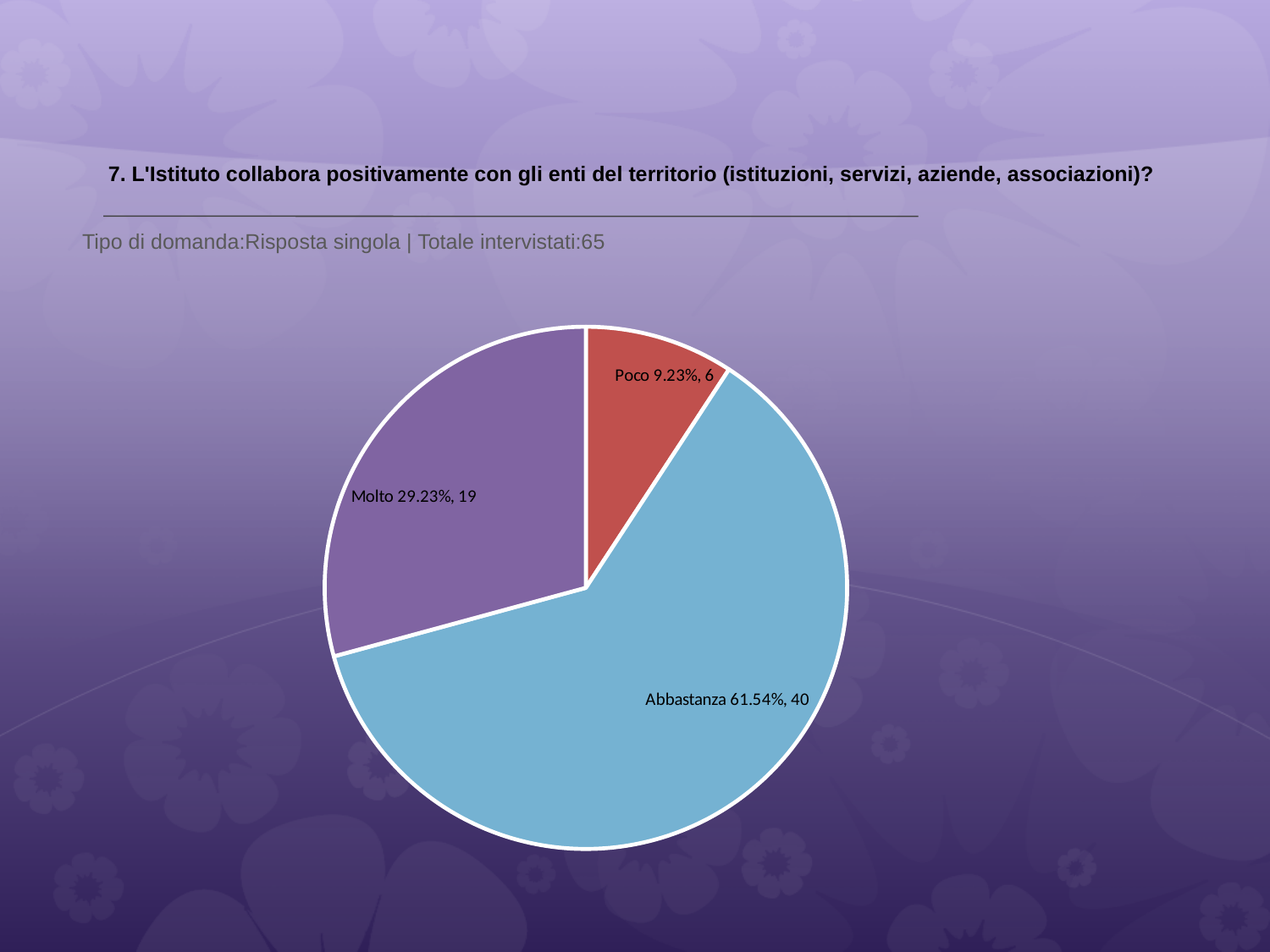
Which slice is larger, Molto or Poco? Molto How many respondents answered Abbastanza? 40 How many slices does the pie chart have? 3 Which response has the smallest slice of the pie? Poco How many more respondents answered Abbastanza than Molto? 21 What percentage share does the Abbastanza slice have? 61.54% How many respondents answered Molto? 19 What percentage share does the Molto slice have? 29.23% What percentage share does the Poco slice have? 9.23% How many respondents answered Poco? 6 What kind of chart is shown on the slide? pie chart Which response has the largest slice of the pie? Abbastanza